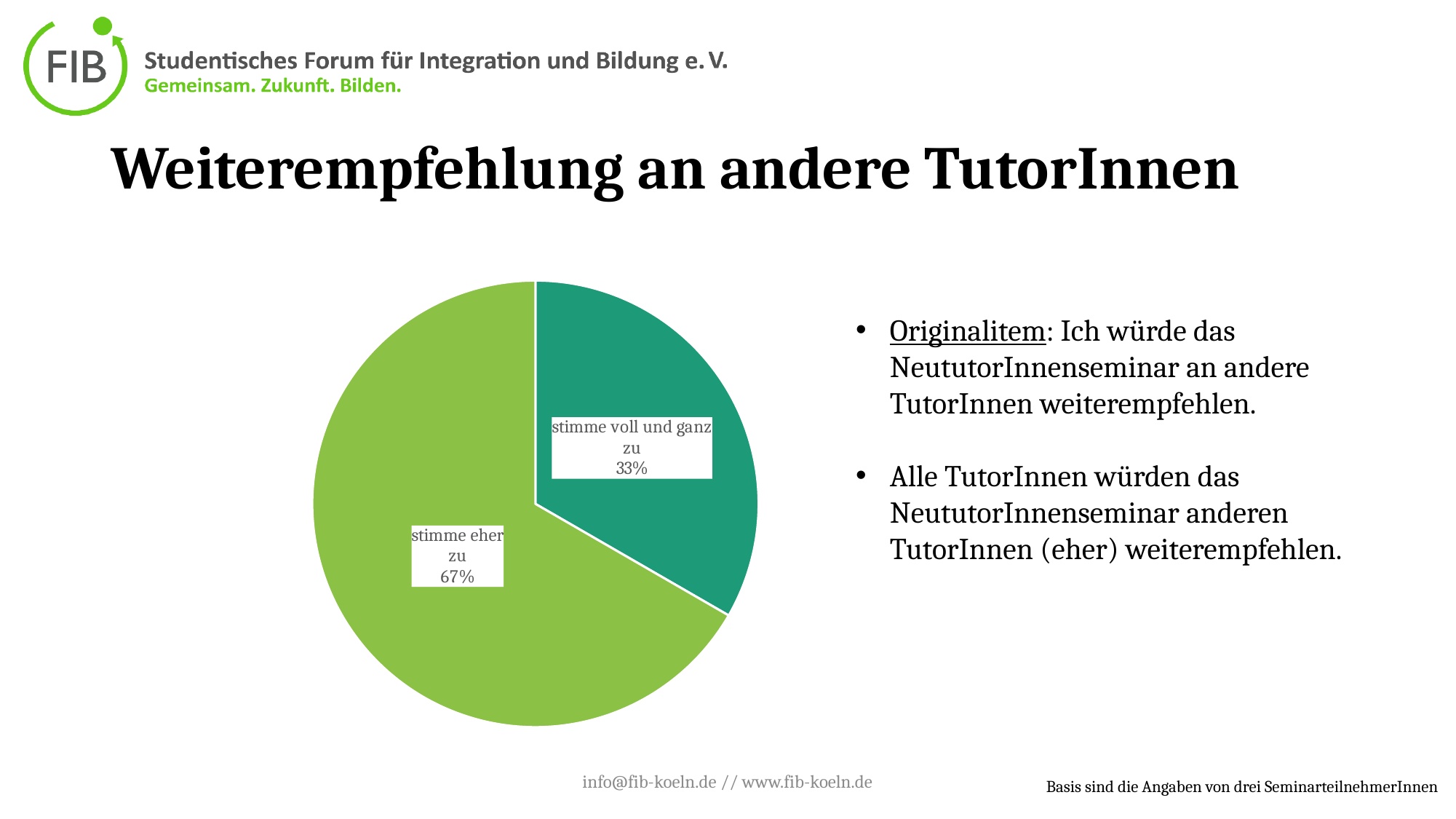
What share of the pie does "stimme voll und ganz zu" have? 33% What kind of chart is shown on the slide? pie chart How many slices does the pie chart have? 2 What colour is the "stimme voll und ganz zu" slice? teal green What share of the pie does "stimme eher zu" have? 67% What colour is the "stimme eher zu" slice? light green Which slice of the pie is the largest? stimme eher zu Which is larger: the share for "stimme eher zu" or for "stimme voll und ganz zu"? stimme eher zu What is the difference in percentage points between "stimme eher zu" and "stimme voll und ganz zu"? 34 Which slice of the pie is the smallest? stimme voll und ganz zu What is the combined share of the two slices in the pie chart? 100%